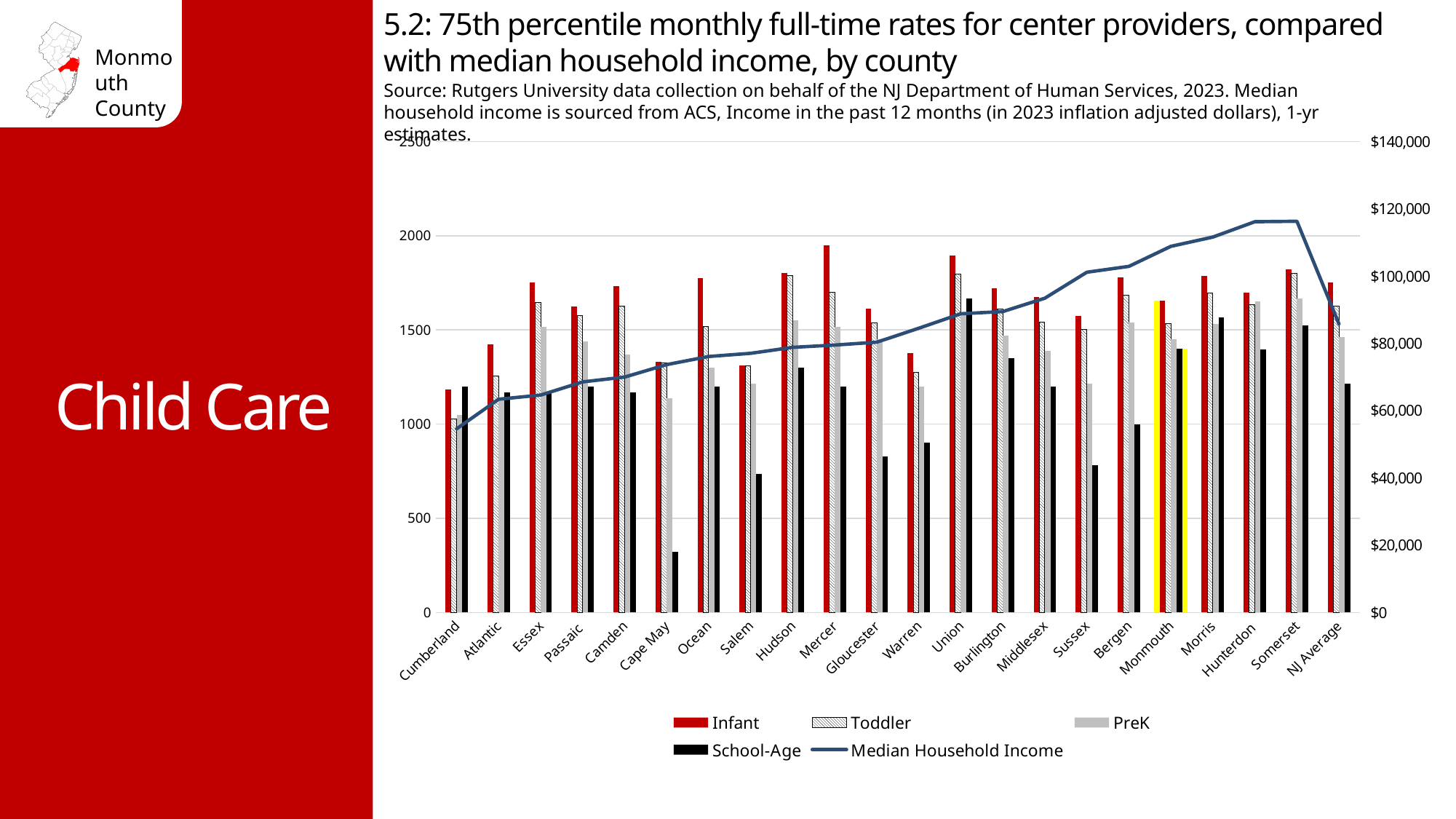
What kind of chart is shown on the slide? Bar chart with a line Which county has the lowest School-Age rate? Cape May Which is larger, the School-Age rate for Salem or for Cape May? Salem Is the School-Age rate for Cape May greater or less than 500? less How many series does the chart legend list? 5 Is the Median Household Income for Somerset greater or less than $100,000? greater How many counties or categories are shown on the x axis of the chart? 22 Does the Median Household Income line generally rise or fall from Cumberland to Somerset? rise Which county has the highest Infant rate? Mercer Is the Infant rate for Mercer greater or less than 1500? greater Which county has the lowest Infant rate? Cumberland Which county has the lowest Median Household Income? Cumberland